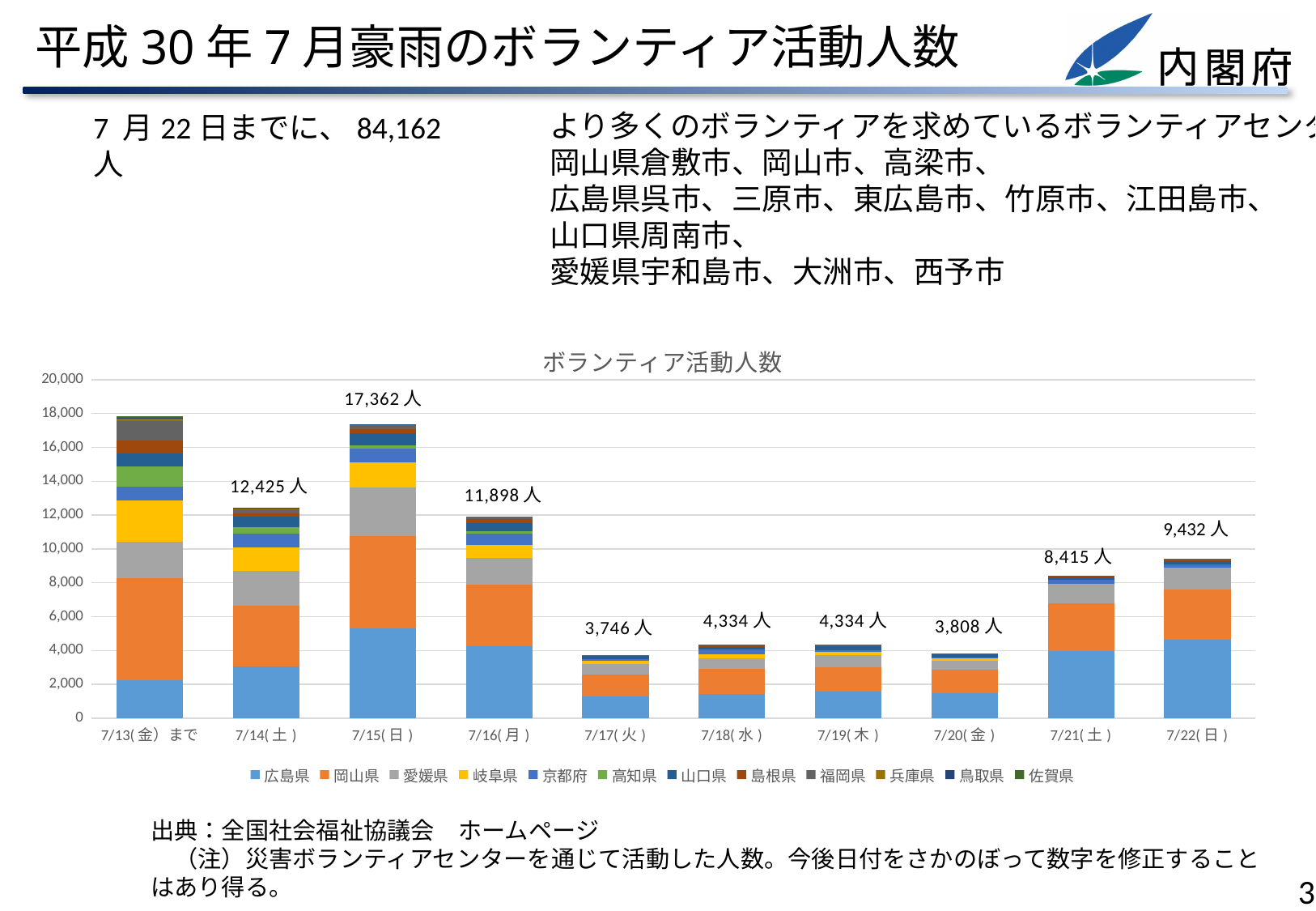
What is the difference between the totals for 7/15(日) and 7/14(土)? 4,937人 Is the total for 7/13(金)まで greater or less than 16,000? greater What kind of chart is shown? Stacked bar chart Is the 広島県 segment for 7/15(日) greater or less than 6,000? less What is the total number of volunteers shown for 7/21(土)? 8,415人 How many prefectures does the legend list? 12 How many dates (categories) are shown on the x axis? 10 Do the totals rise or fall from 7/20(金) to 7/22(日)? rise What is the difference between the totals for 7/22(日) and 7/21(土)? 1,017人 What is the total number of volunteers shown for 7/15(日)? 17,362人 Which has a larger total, 7/14(土) or 7/16(月)? 7/14(土) What is the total number of volunteers shown for 7/17(火)? 3,746人